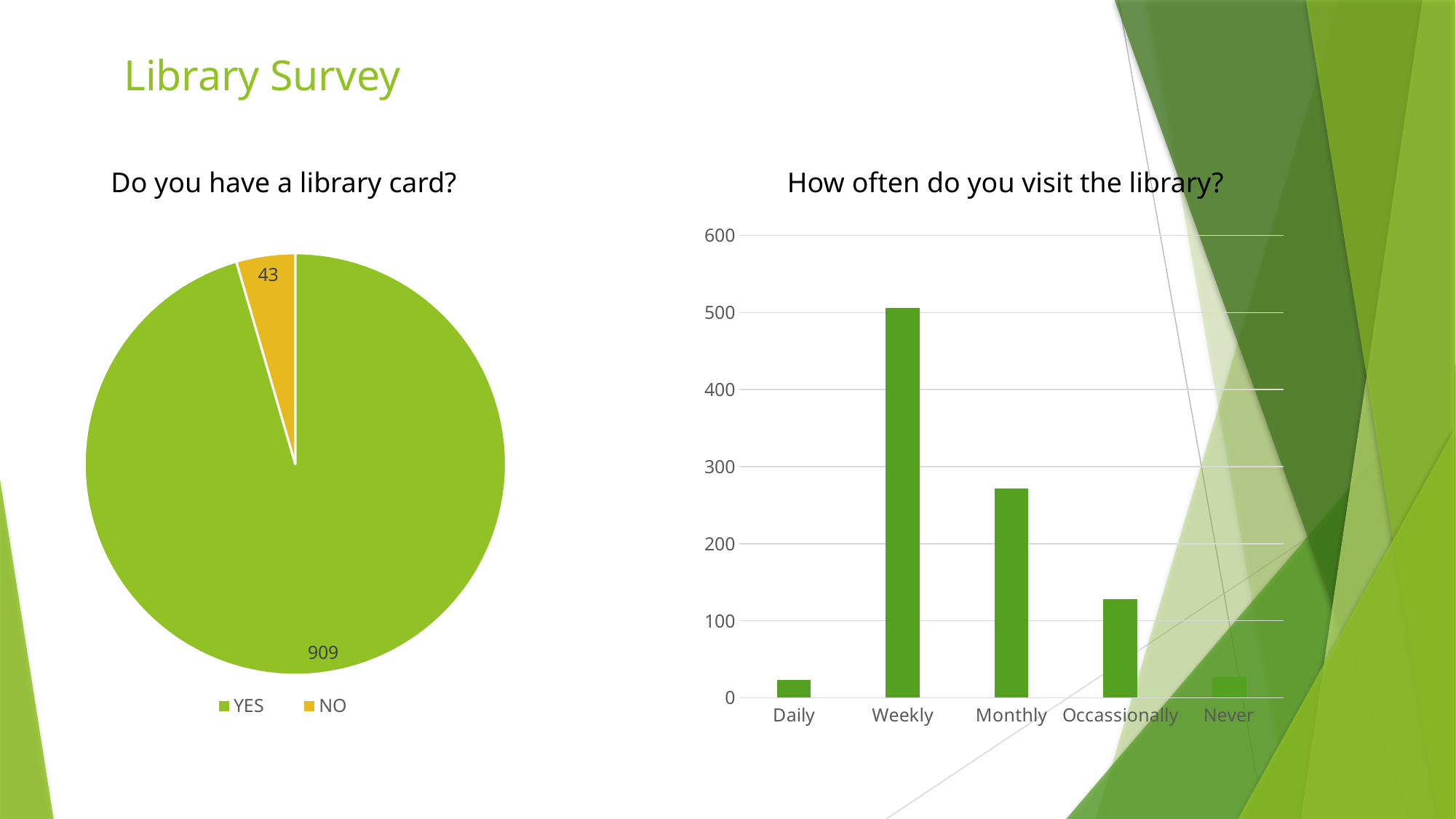
In the pie chart 'Do you have a library card?', which answer has the larger slice? YES In the pie chart 'Do you have a library card?', what is the difference between the YES and NO counts? 866 In the pie chart 'Do you have a library card?', what is the total of the YES and NO counts? 952 What kind of chart is 'How often do you visit the library?'? bar chart In the pie chart 'Do you have a library card?', how many respondents answered NO? 43 In the chart 'How often do you visit the library?', is the value for Monthly greater or less than 300? less In the pie chart 'Do you have a library card?', how many respondents answered YES? 909 In the pie chart 'Do you have a library card?', how many entries does the legend list? 2 In the chart 'How often do you visit the library?', which category has the highest value? Weekly In the chart 'How often do you visit the library?', which is larger, Monthly or Occasionally? Monthly In the chart 'How often do you visit the library?', how many categories are shown on the x axis? 5